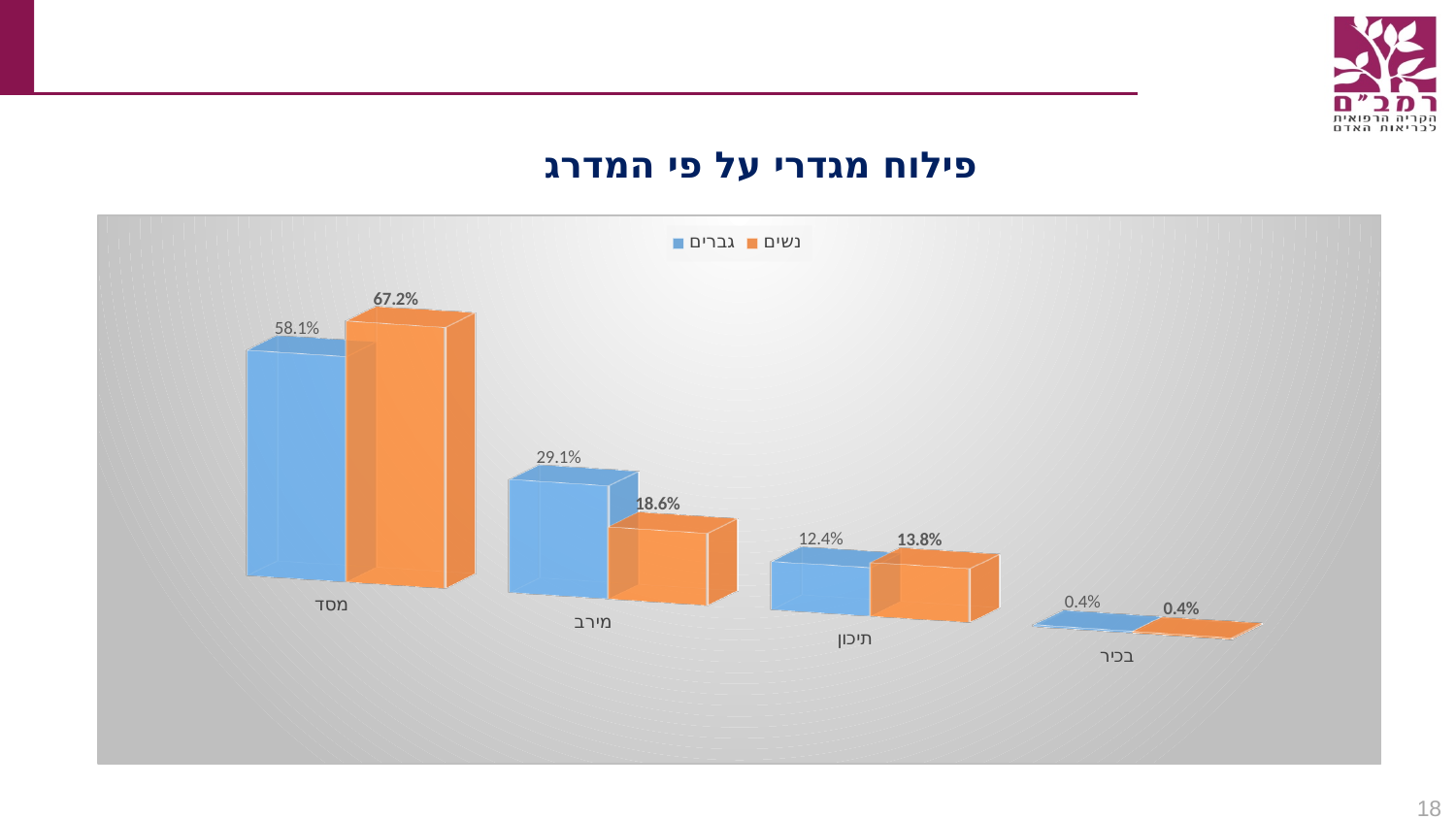
How many series does the legend list? 2 Which category has the lowest value for גברים? בכיר How many categories are shown on the x axis? 4 What kind of chart is shown on the slide? Bar chart Which colour represents the גברים series? Blue What is the difference between the גברים and נשים values in the מסד category? 9.1% What is the value for נשים in the תיכון category? 13.8% What is the value for גברים in the מסד category? 58.1% What is the value for נשים in the מסד category? 67.2% What is the value for גברים in the מירב category? 29.1% In the מירב category, which series has the larger value, נשים or גברים? גברים Which category has the highest value for נשים? מסד